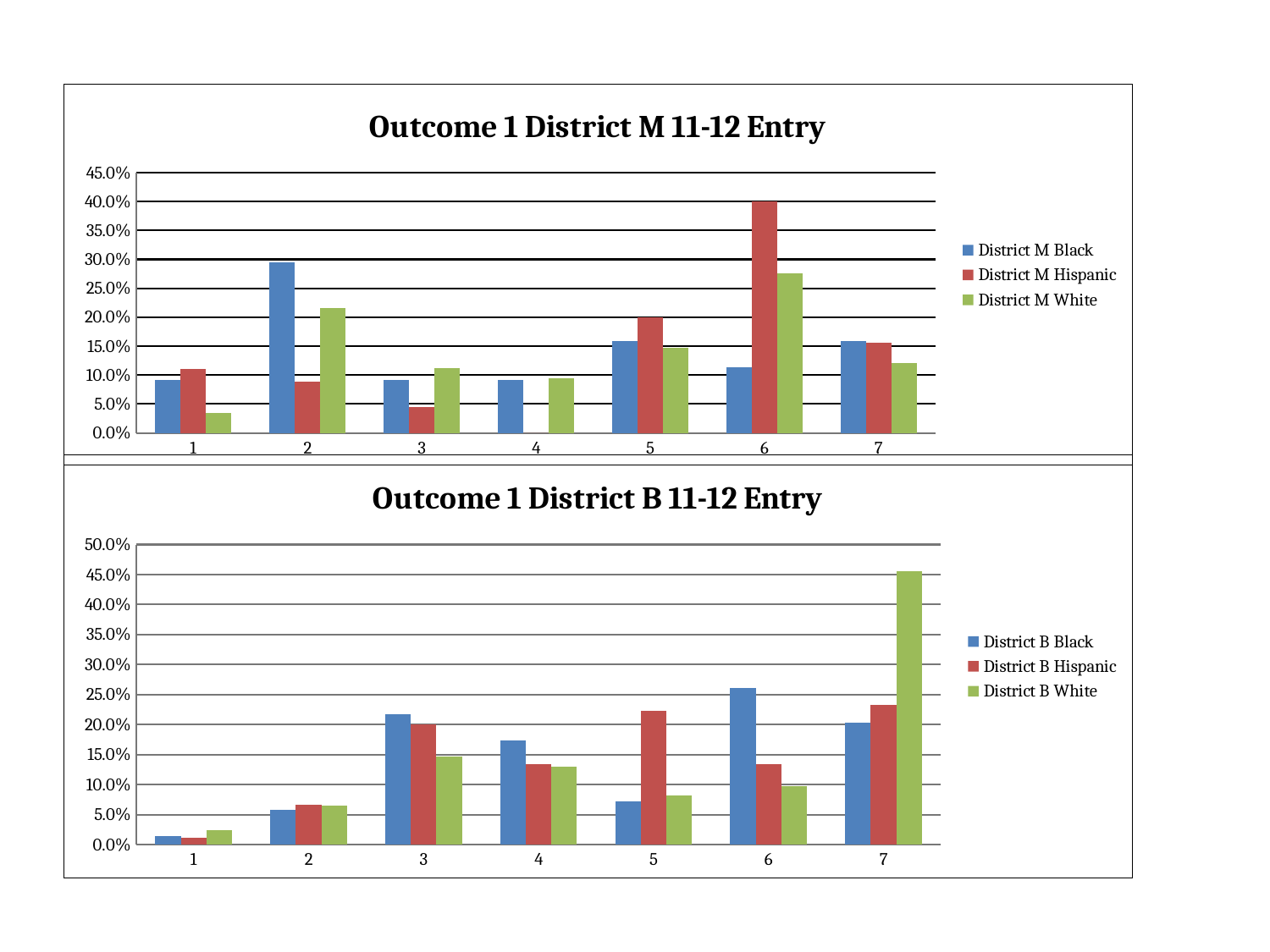
In the chart titled "Outcome 1 District M 11-12 Entry", is the value for District M Black at category 2 greater or less than 25.0%? greater In the chart titled "Outcome 1 District B 11-12 Entry", is the value for District B Black at category 1 greater or less than 5.0%? less In the chart titled "Outcome 1 District M 11-12 Entry", how many series does the legend list? 3 In the chart titled "Outcome 1 District B 11-12 Entry", which category has the lowest value for District B Black? 1 In the chart titled "Outcome 1 District M 11-12 Entry", is the value for District M Hispanic at category 6 greater or less than 35.0%? greater In the chart titled "Outcome 1 District B 11-12 Entry", at category 5, which is larger: District B Black or District B Hispanic? District B Hispanic In the chart titled "Outcome 1 District M 11-12 Entry", which category has the lowest value for District M White? 1 In the chart titled "Outcome 1 District B 11-12 Entry", which category has the highest value for District B White? 7 What kind of chart is the top chart, "Outcome 1 District M 11-12 Entry"? bar chart In the chart titled "Outcome 1 District M 11-12 Entry", which category has the highest value for District M Hispanic? 6 In the chart titled "Outcome 1 District B 11-12 Entry", how many categories are shown on the x axis? 7